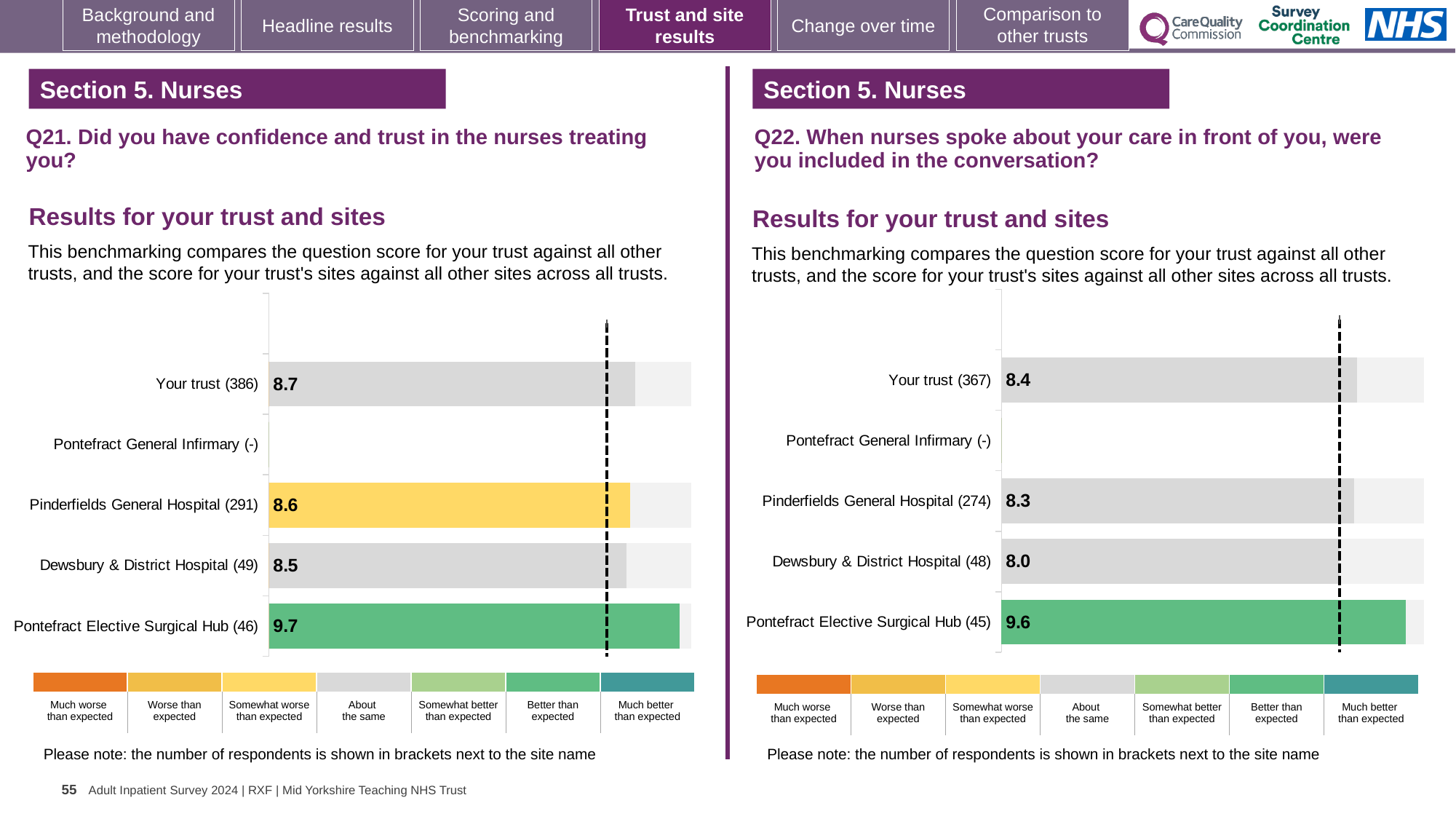
On the Q22 chart (right), what is the score for Dewsbury & District Hospital (48)? 8.0 On the Q21 chart (left), which site has the highest score? Pontefract Elective Surgical Hub (46) On the Q22 chart (right), what is the difference between the scores for Pontefract Elective Surgical Hub (45) and Your trust (367)? 1.2 On the Q22 chart (right), which site with a plotted score has the lowest score? Dewsbury & District Hospital (48) What type of chart is used on the Q22 chart (right)? Bar chart On the Q22 chart (right), which is larger: the score for Your trust (367) or for Pinderfields General Hospital (274)? Your trust (367) On the Q21 chart (left), what is the score for Pontefract Elective Surgical Hub (46)? 9.7 On the Q21 chart (left), what is the score for Your trust (386)? 8.7 How many rows (trust and sites) are listed on the Q21 chart (left)? 5 On the Q21 chart (left), what is the difference between the scores for Pinderfields General Hospital (291) and Dewsbury & District Hospital (49)? 0.1 On the Q22 chart (right), what is the score for Pinderfields General Hospital (274)? 8.3 On the Q21 chart (left), which site's bar is coloured yellow? Pinderfields General Hospital (291)